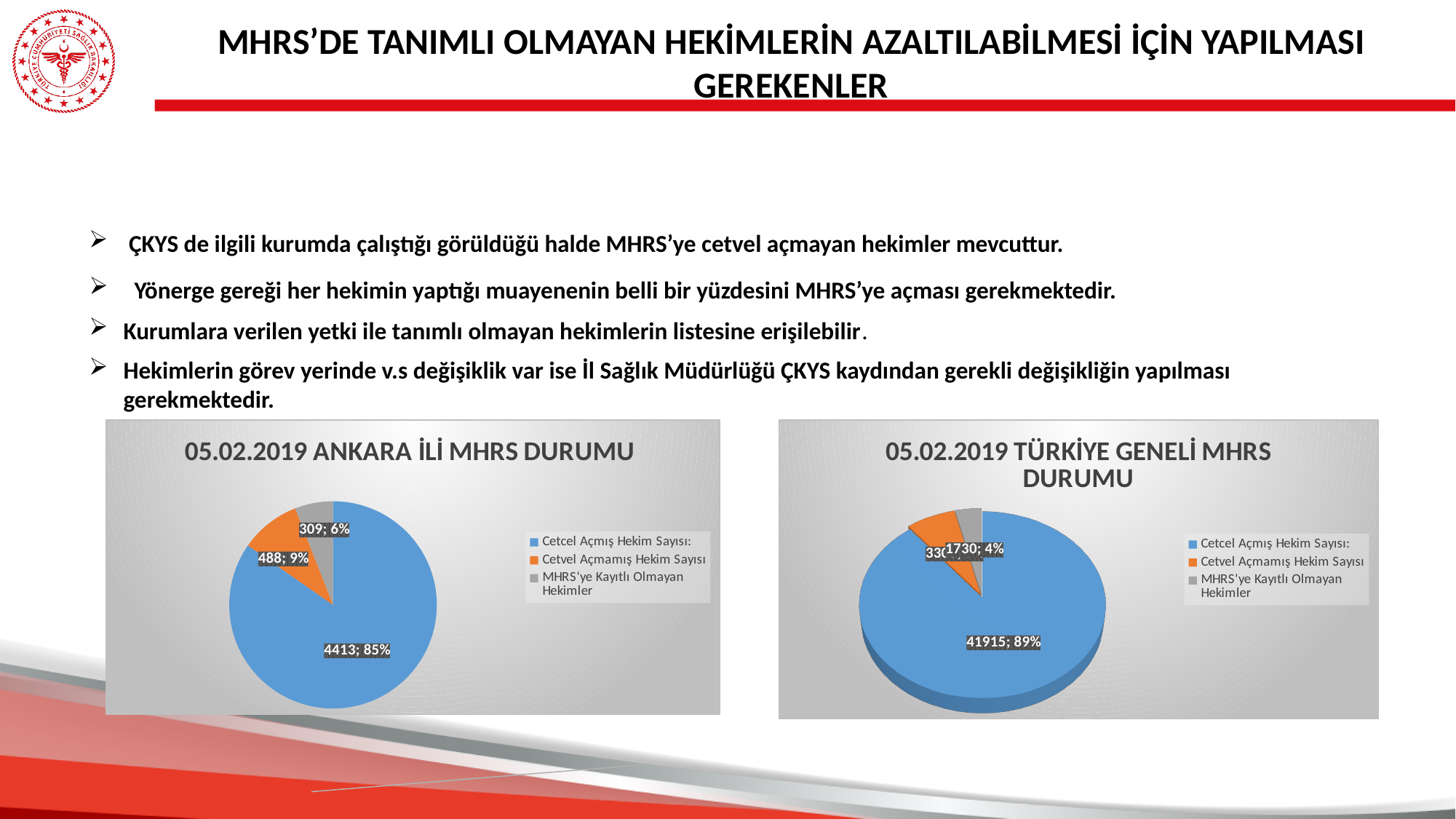
In the chart titled "05.02.2019 ANKARA İLİ MHRS DURUMU", what value is shown for MHRS'ye Kayıtlı Olmayan Hekimler? 309 In the chart titled "05.02.2019 ANKARA İLİ MHRS DURUMU", what is the difference between the values for Cetvel Açmamış Hekim Sayısı and MHRS'ye Kayıtlı Olmayan Hekimler? 179 In the chart titled "05.02.2019 TÜRKİYE GENELİ MHRS DURUMU", what value is shown for Cetcel Açmış Hekim Sayısı? 41915 How many categories does the legend of the chart titled "05.02.2019 TÜRKİYE GENELİ MHRS DURUMU" list? 3 In the chart titled "05.02.2019 ANKARA İLİ MHRS DURUMU", what colour is the slice for Cetvel Açmamış Hekim Sayısı? Orange In the chart titled "05.02.2019 ANKARA İLİ MHRS DURUMU", what value is shown for Cetvel Açmamış Hekim Sayısı? 488 In the chart titled "05.02.2019 ANKARA İLİ MHRS DURUMU", which category has the smallest slice? MHRS'ye Kayıtlı Olmayan Hekimler In the chart titled "05.02.2019 ANKARA İLİ MHRS DURUMU", what value is shown for Cetcel Açmış Hekim Sayısı? 4413 In the chart titled "05.02.2019 TÜRKİYE GENELİ MHRS DURUMU", which category has the largest slice? Cetcel Açmış Hekim Sayısı What kind of chart is the one titled "05.02.2019 ANKARA İLİ MHRS DURUMU"? Pie chart In the chart titled "05.02.2019 TÜRKİYE GENELİ MHRS DURUMU", what share of the pie does Cetcel Açmış Hekim Sayısı represent? 89% In the chart titled "05.02.2019 ANKARA İLİ MHRS DURUMU", what share of the pie does Cetvel Açmamış Hekim Sayısı represent? 9%